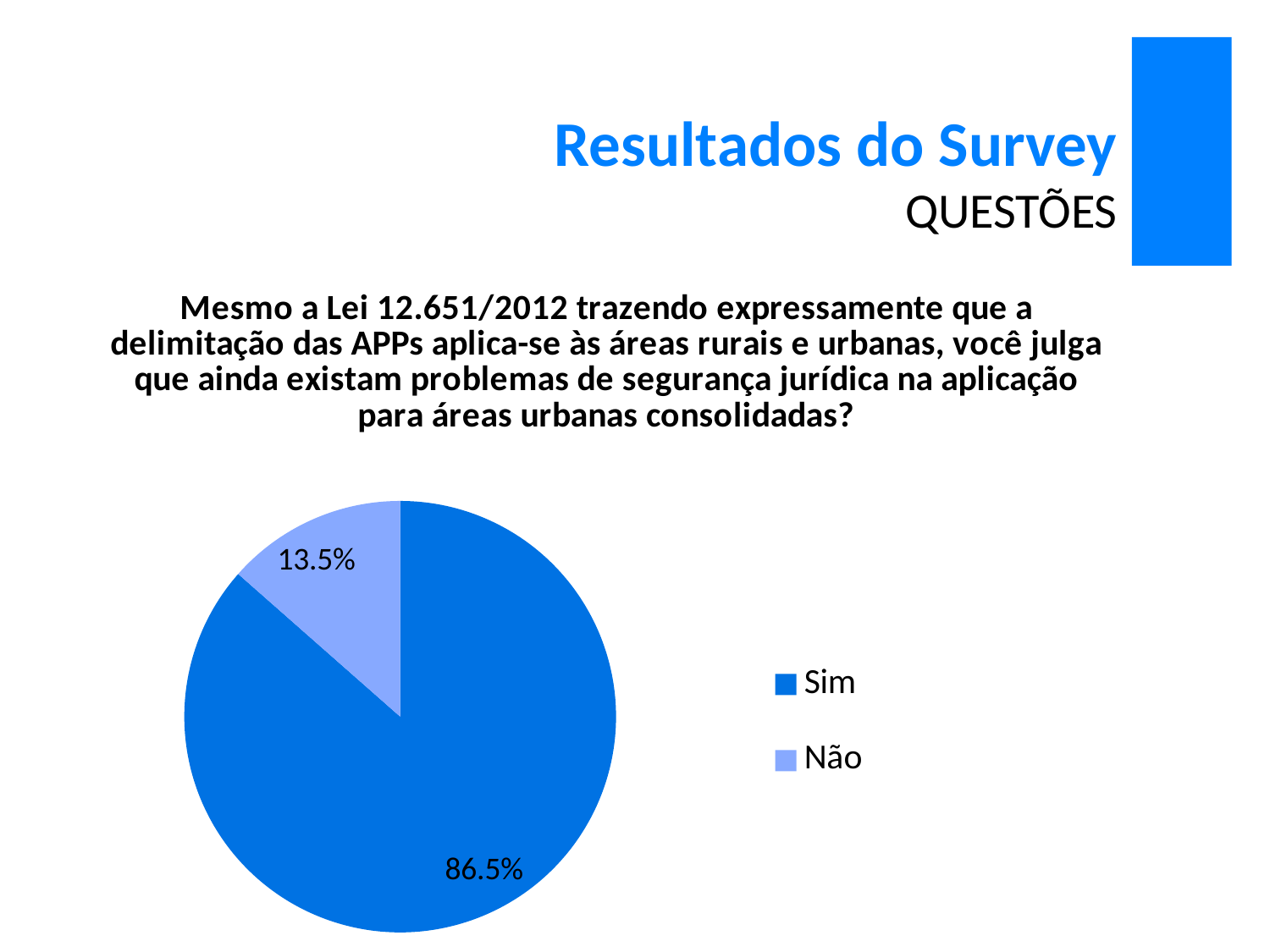
What percentage of respondents answered "Não"? 13.5% How many slices does the pie chart have? 2 Which response has the smallest share of the pie? Não Which slice is larger, "Sim" or "Não"? Sim What type of chart is shown on the slide? pie chart What is the difference in percentage points between the "Sim" and "Não" slices? 73 percentage points What share of the pie does the "Não" slice represent? 13.5% What percentage of respondents answered "Sim"? 86.5% Which legend entry is shown in the lighter blue colour? Não Which response has the largest share of the pie? Sim How many entries does the legend list? 2 What is the main title at the top of the slide? Resultados do Survey